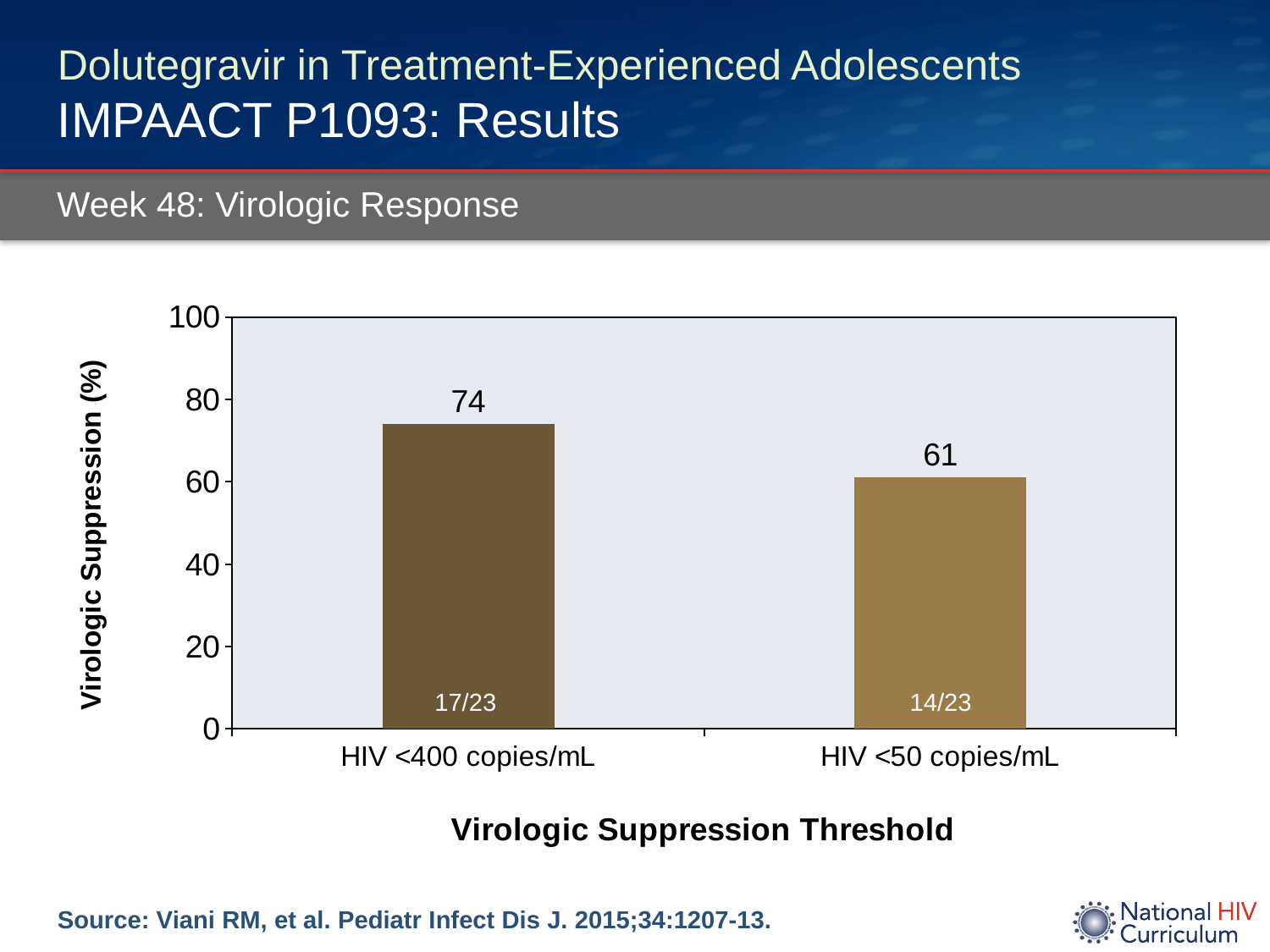
Which virologic suppression threshold has the higher suppression percentage? HIV <400 copies/mL What is the difference in virologic suppression percentage between HIV <400 copies/mL and HIV <50 copies/mL? 13 How many virologic suppression thresholds are shown on the chart? 2 Is the virologic suppression value for HIV <50 copies/mL greater or less than 80? less What is the virologic suppression percentage for HIV <400 copies/mL? 74 What kind of chart is shown on the slide? Bar chart What is the label of the x axis of the chart? Virologic Suppression Threshold What is the virologic suppression percentage for HIV <50 copies/mL? 61 Is the virologic suppression value for HIV <400 copies/mL greater or less than 60? greater Which virologic suppression threshold has the lower suppression percentage? HIV <50 copies/mL What fraction of participants is shown inside the bar for HIV <400 copies/mL? 17/23 What fraction of participants is shown inside the bar for HIV <50 copies/mL? 14/23